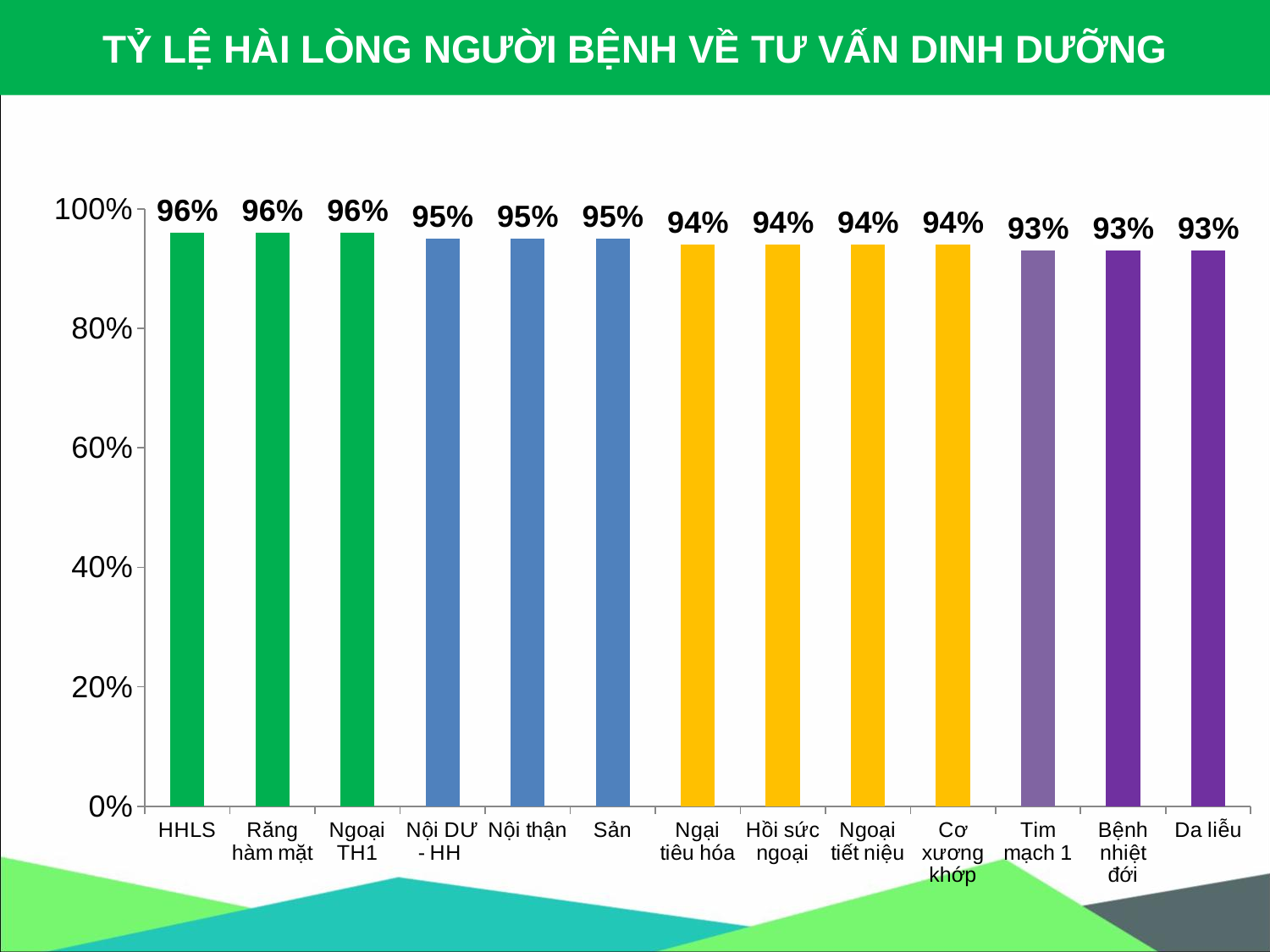
What is the value for Da liễu? 93% What is the value for Cơ xương khớp? 94% What is the difference between the value for HHLS and the value for Tim mạch 1? 3 percentage points Which has a higher value, Ngoại TH1 or Bệnh nhiệt đới? Ngoại TH1 Is the value for Sản greater or less than 80%? greater What is the value for HHLS? 96% Do the values rise or fall from left to right along the x axis? Fall What kind of chart is shown on the slide? Bar chart What is the highest value shown in the chart? 96% What is the lowest value shown in the chart? 93% How many categories are shown in the chart? 13 What is the value for Nội thận? 95%